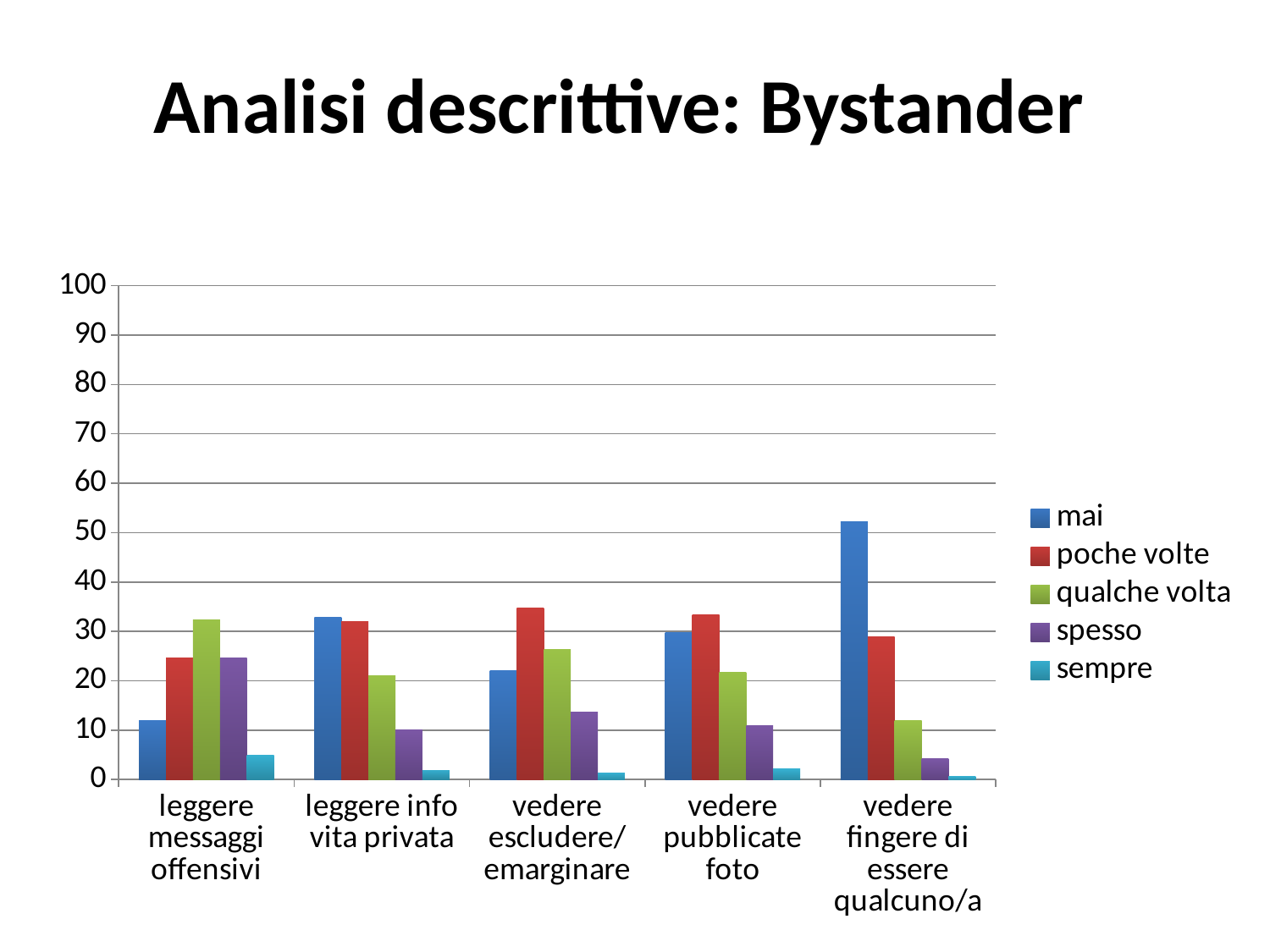
Is the value for 'poche volte' in the category 'vedere escludere/emarginare' greater or less than 30? greater In the category 'leggere messaggi offensivi', which is larger: 'mai' or 'qualche volta'? qualche volta Is the value for 'mai' in the category 'vedere fingere di essere qualcuno/a' greater or less than 50? greater How many series does the legend list? 5 Which category has the highest bar for the series 'mai'? vedere fingere di essere qualcuno/a What is the title of the slide? Analisi descrittive: Bystander How many categories are shown along the x axis? 5 Which series has the lowest bar in every category? sempre In the category 'vedere fingere di essere qualcuno/a', which is larger: 'mai' or 'poche volte'? mai Which series is shown in red in the legend? poche volte What kind of chart is shown on the slide? bar chart Is the value for 'mai' in the category 'leggere messaggi offensivi' greater or less than 20? less